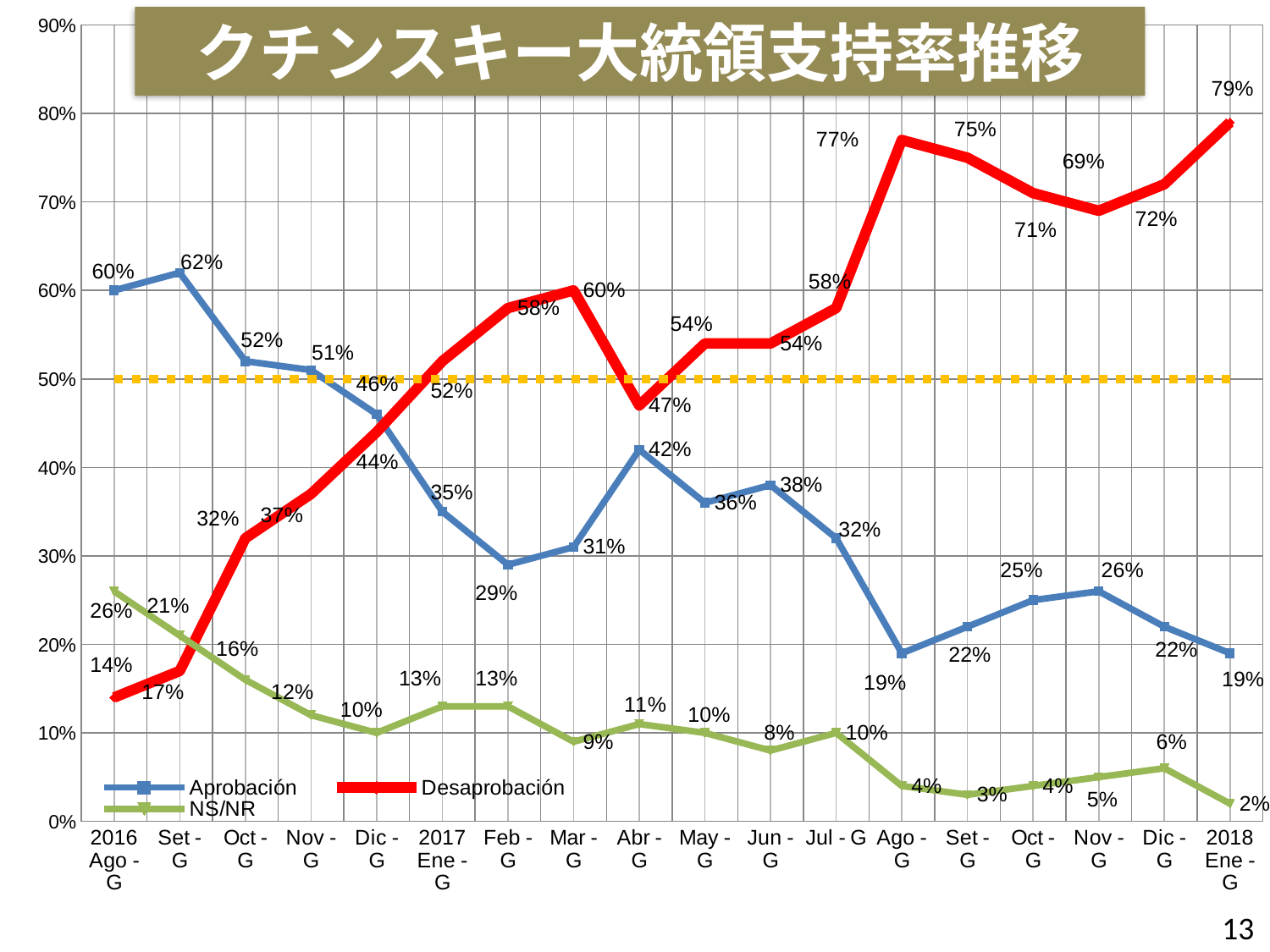
How many series does the legend list? 3 What kind of chart is this? Line chart What is the lowest NS/NR value shown? 2% What is the difference between Desaprobación and Aprobación at Ago - G (2017)? 58% Does the Desaprobación series generally rise or fall from 2016 Ago - G to 2018 Ene - G? Rise In which month does Desaprobación reach its highest value? 2018 Ene - G Which is larger at Dic - G (2016): Aprobación or Desaprobación? Aprobación In which month does Aprobación reach its highest value? Set - G (2016) What is the Aprobación value for 2016 Ago - G? 60% What is the NS/NR value for Abr - G? 11% How many time points are plotted on the x axis? 18 What is the Desaprobación value for 2018 Ene - G? 79%